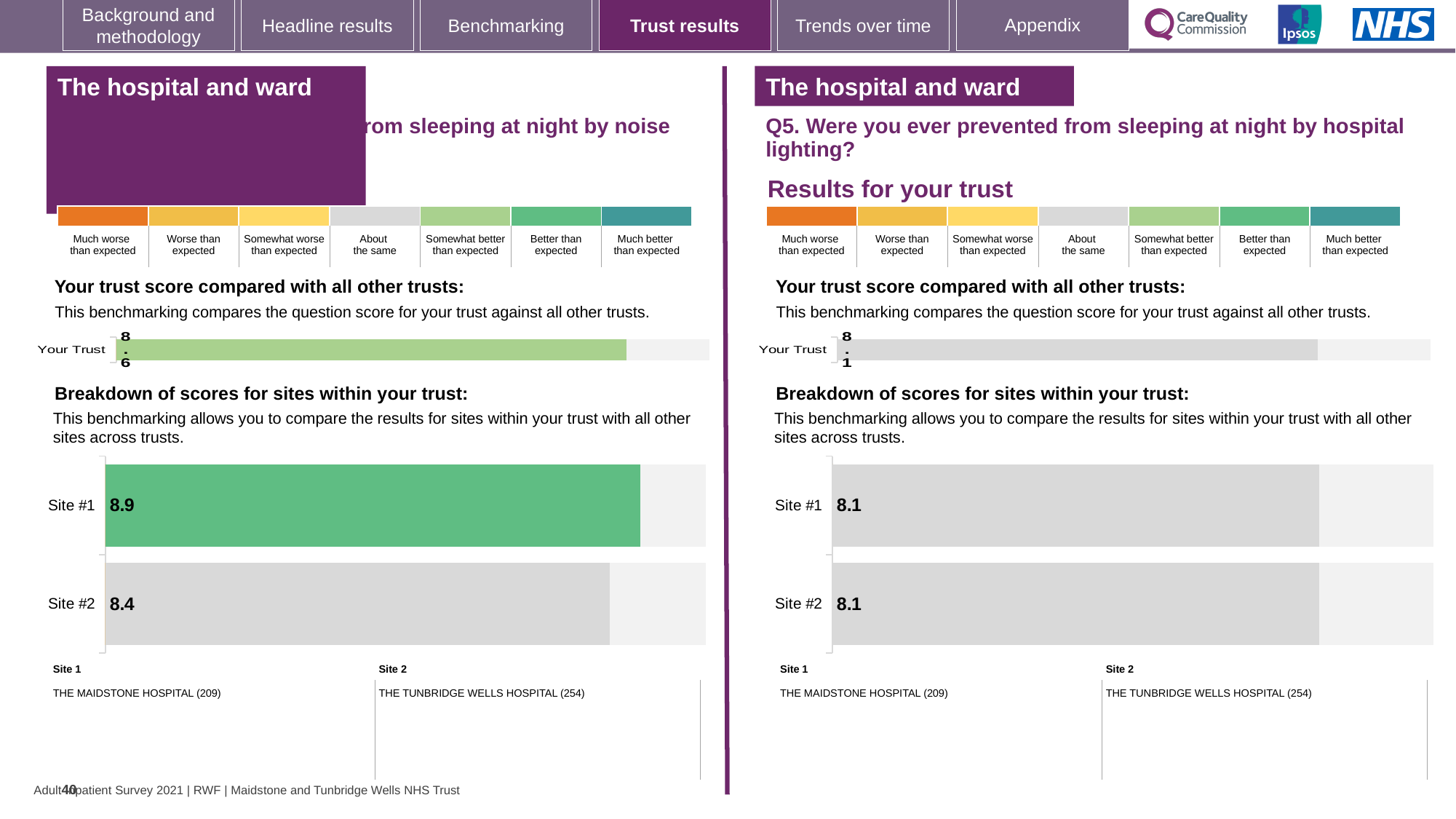
What type of chart is used for the site breakdown on the right-hand side of the slide? bar chart In the left-hand 'Breakdown of scores for sites within your trust' chart, what is the score for Site #2? 8.4 On the right-hand side of the slide (Q5, hospital lighting), what is the 'Your Trust' score shown in the trust comparison bar? 8.1 Is the left-hand 'Your Trust' score (8.6) larger or smaller than the right-hand 'Your Trust' score (8.1)? larger In the right-hand 'Breakdown of scores for sites within your trust' chart (Q5, hospital lighting), what is the score for Site #1? 8.1 In the left-hand site breakdown chart, which site has the higher score? Site #1 On the left-hand side of the slide, what is the 'Your Trust' score shown in the trust comparison bar? 8.6 In the left-hand 'Breakdown of scores for sites within your trust' chart, what is the score for Site #1? 8.9 In the left-hand site breakdown chart, what is the difference between the Site #1 and Site #2 scores? 0.5 In the left-hand site breakdown chart, what colour is the Site #1 bar? green In the right-hand site breakdown chart (Q5, hospital lighting), what is the difference between the Site #1 and Site #2 scores? 0 How many sites are shown in the left-hand site breakdown chart? 2